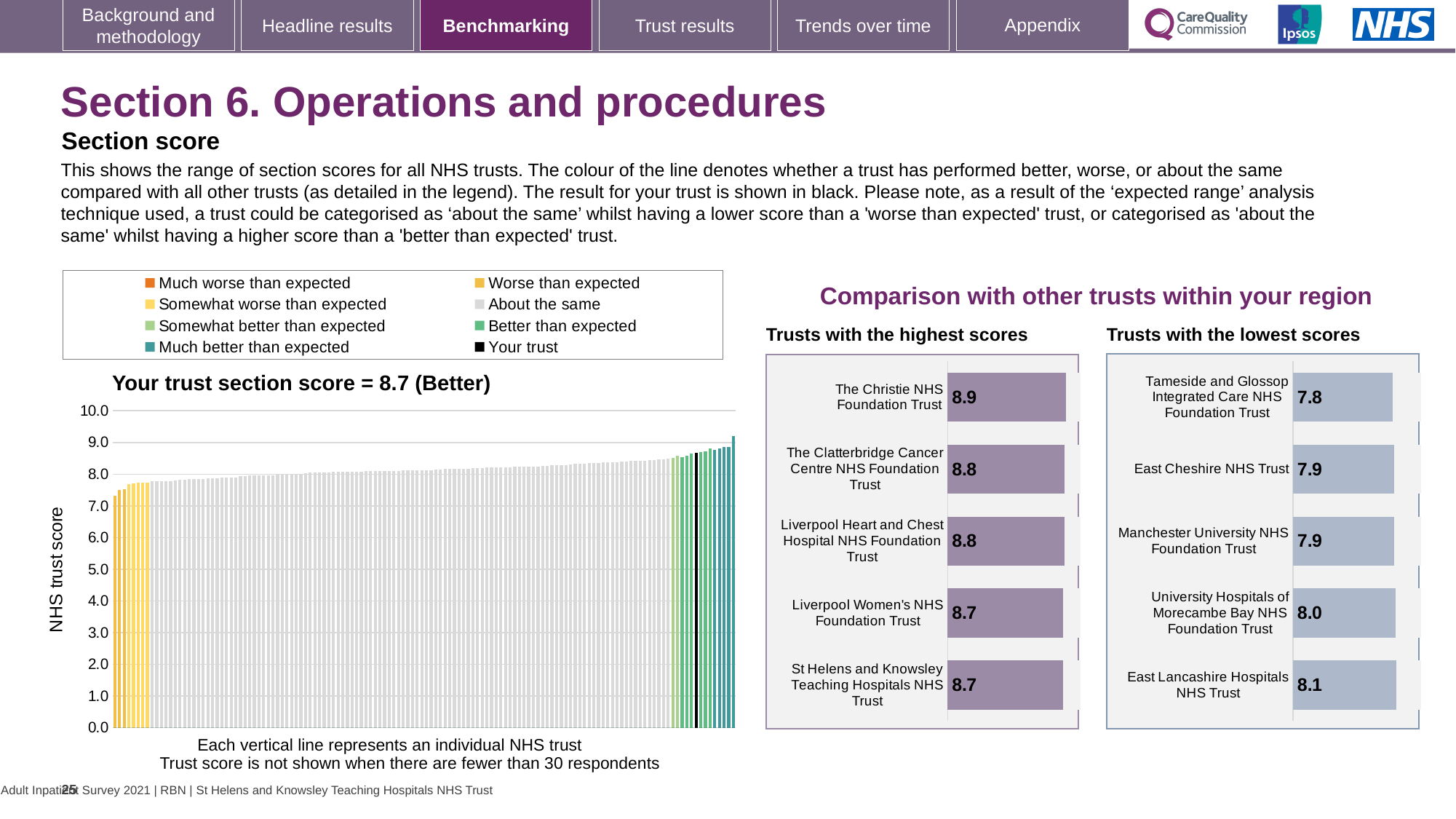
What kind of chart is the 'Your trust section score' chart? bar chart How many trusts are shown on the 'Trusts with the highest scores' chart? 5 On the 'Trusts with the lowest scores' chart, which trust has the lowest score? Tameside and Glossop Integrated Care NHS Foundation Trust On the 'Your trust section score' chart, do the bar heights rise or fall from left to right? rise On the 'Trusts with the highest scores' chart, which trust has the highest score? The Christie NHS Foundation Trust What is the difference between The Christie NHS Foundation Trust's score on the 'Trusts with the highest scores' chart and Tameside and Glossop Integrated Care NHS Foundation Trust's score on the 'Trusts with the lowest scores' chart? 1.1 What is the y-axis label on the 'Your trust section score' chart? NHS trust score On the 'Trusts with the highest scores' chart, what is the score for The Christie NHS Foundation Trust? 8.9 On the 'Your trust section score' chart, is the value of the leftmost bar greater or less than 8.0? less On the 'Trusts with the lowest scores' chart, what is the score for East Cheshire NHS Trust? 7.9 How many entries does the legend above the 'Your trust section score' chart list? 8 On the 'Your trust section score' chart, what is the trust's section score shown in the title? 8.7 (Better)